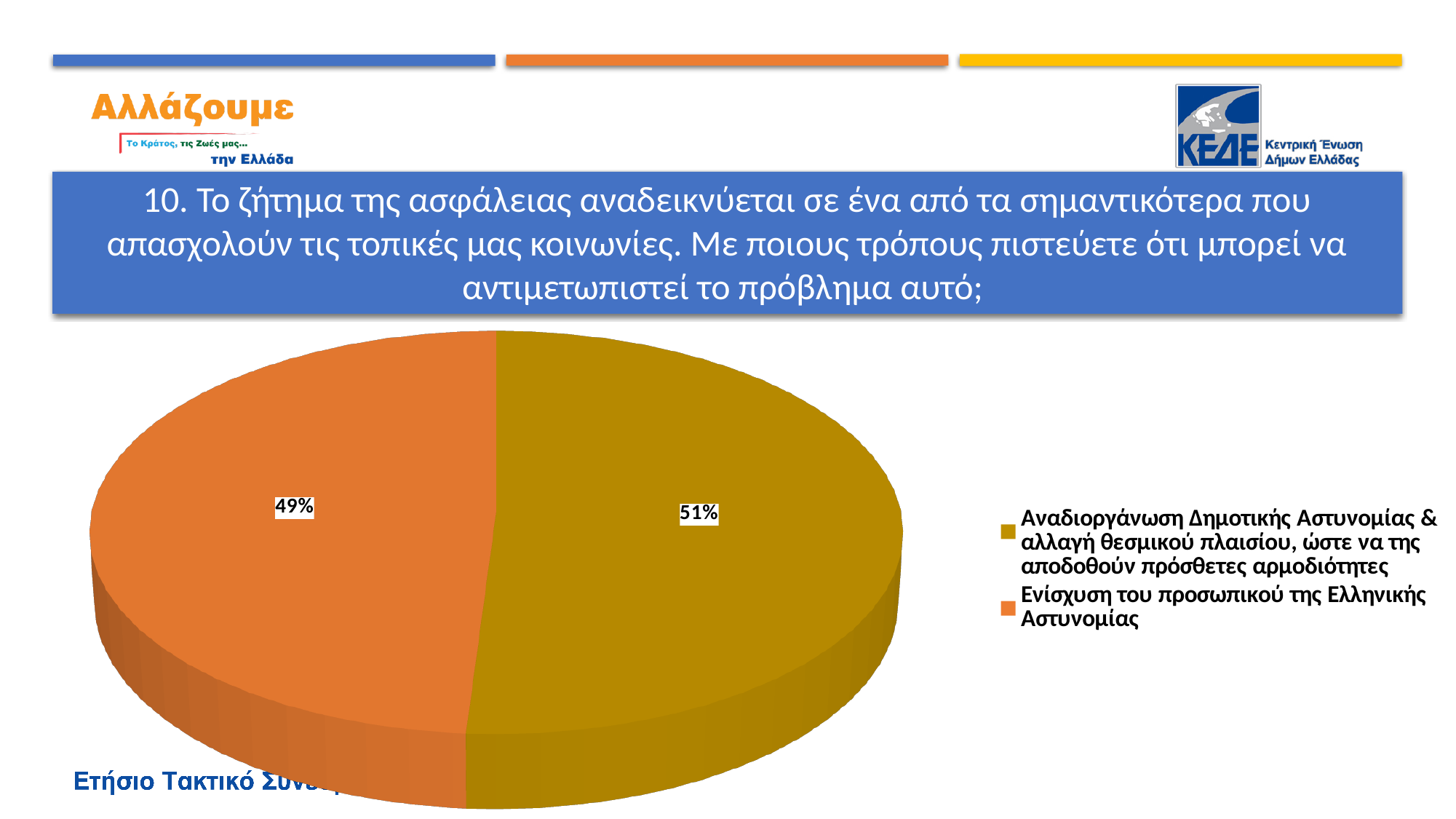
Which is larger: the slice for "Ενίσχυση του προσωπικού της Ελληνικής Αστυνομίας" or the slice for "Αναδιοργάνωση Δημοτικής Αστυνομίας & αλλαγή θεσμικού πλαισίου, ώστε να της αποδοθούν πρόσθετες αρμοδιότητες"? Αναδιοργάνωση Δημοτικής Αστυνομίας & αλλαγή θεσμικού πλαισίου, ώστε να της αποδοθούν πρόσθετες αρμοδιότητες Is the share for "Ενίσχυση του προσωπικού της Ελληνικής Αστυνομίας" greater or less than 50%? less What kind of chart is shown on the slide? pie chart Which category has the largest slice of the pie? Αναδιοργάνωση Δημοτικής Αστυνομίας & αλλαγή θεσμικού πλαισίου, ώστε να της αποδοθούν πρόσθετες αρμοδιότητες What is the difference in percentage points between the two slices of the pie? 2 percentage points How many slices does the pie chart have? 2 What share of the pie is labelled for "Αναδιοργάνωση Δημοτικής Αστυνομίας & αλλαγή θεσμικού πλαισίου, ώστε να της αποδοθούν πρόσθετες αρμοδιότητες"? 51% How many entries does the legend list? 2 What colour is the slice for "Ενίσχυση του προσωπικού της Ελληνικής Αστυνομίας"? orange Which category has the smallest slice of the pie? Ενίσχυση του προσωπικού της Ελληνικής Αστυνομίας What colour is the slice labelled 51%? gold What share of the pie is labelled for "Ενίσχυση του προσωπικού της Ελληνικής Αστυνομίας"? 49%